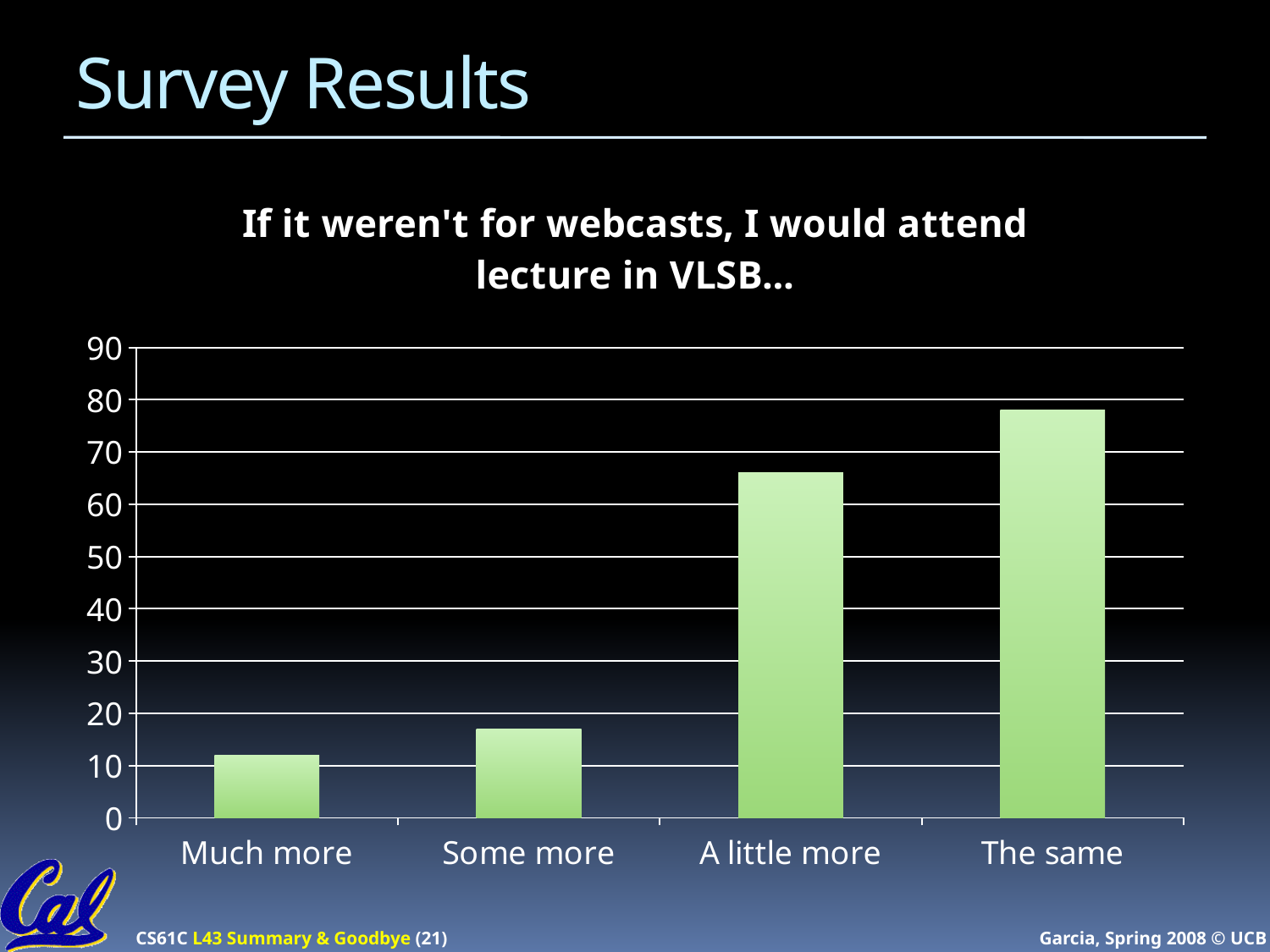
Is the value for Some more greater or less than 20? less How many categories are shown on the x axis? 4 Which category has the lowest value? Much more Is the value for The same greater or less than 70? greater Is the value for A little more greater or less than 60? greater What kind of chart is shown on the slide? bar chart Do the values rise or fall from left to right along the x axis? rise Which is larger, the value for Some more or the value for A little more? A little more Which category has the highest value? The same What is the title of the chart? If it weren't for webcasts, I would attend lecture in VLSB...